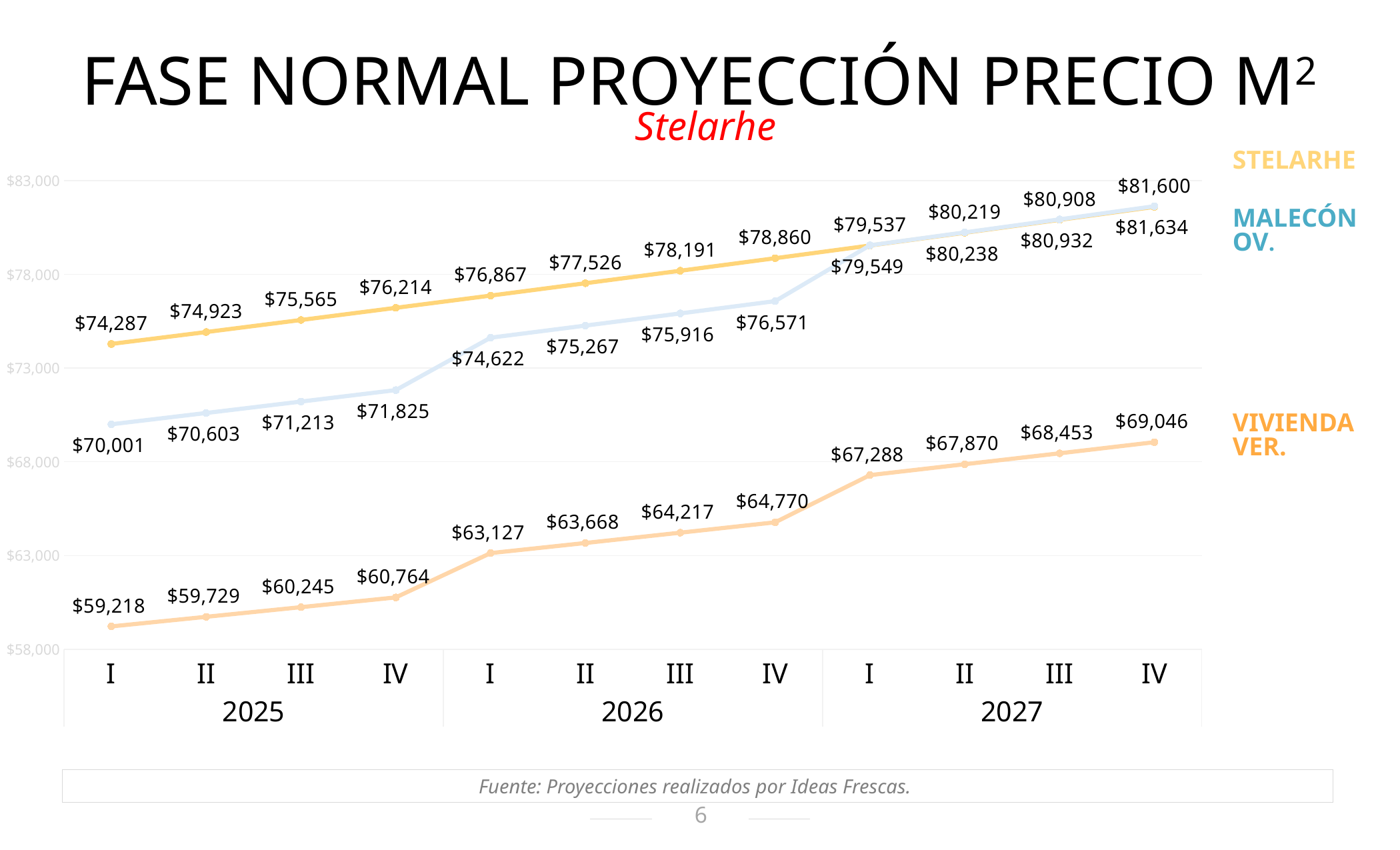
Which series has the lowest value in quarter I of 2025? VIVIENDA VER. How many quarterly points are plotted for each series? 12 How many series does the chart show? 3 Which series has the highest value in quarter IV of 2026? STELARHE What is the VIVIENDA VER. value in quarter I of 2026? $63,127 What is the MALECÓN OV. value in quarter IV of 2027? $81,634 What kind of chart is shown on the slide? line chart Which is larger in quarter I of 2027: the STELARHE value or the MALECÓN OV. value? MALECÓN OV. What is the difference between the STELARHE and VIVIENDA VER. values in quarter IV of 2027? $12,554 Do the VIVIENDA VER. values rise or fall from 2025 to 2027? rise What is the STELARHE value in quarter I of 2025? $74,287 What is the source cited below the chart? Proyecciones realizados por Ideas Frescas.